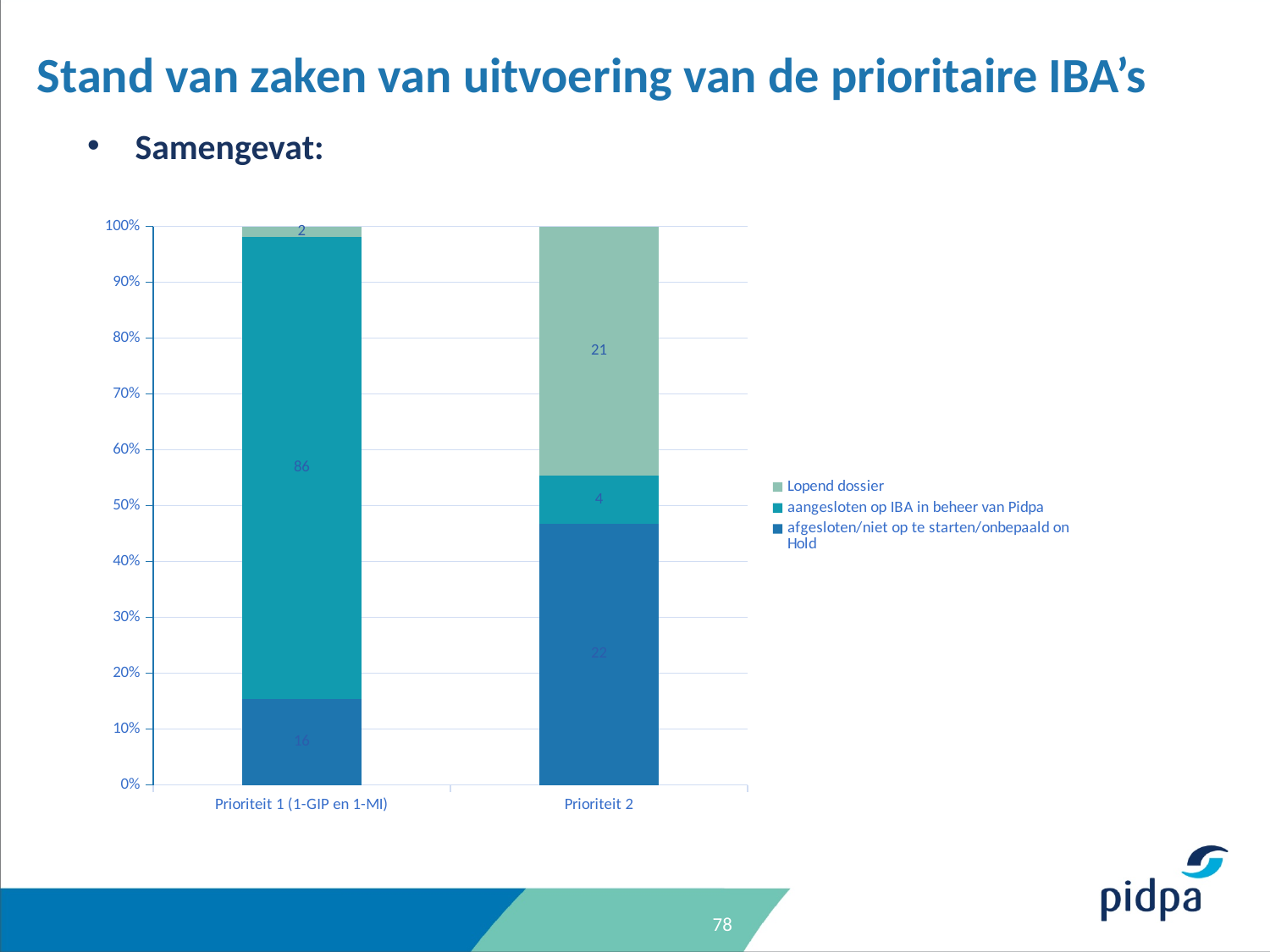
How many series does the legend list? 3 How many categories are shown on the x axis? 2 What is the difference between the 'afgesloten/niet op te starten/onbepaald on Hold' values for Prioriteit 2 and Prioriteit 1 (1-GIP en 1-MI)? 6 Which category has the larger 'aangesloten op IBA in beheer van Pidpa' value, Prioriteit 1 (1-GIP en 1-MI) or Prioriteit 2? Prioriteit 1 (1-GIP en 1-MI) What is the value of the 'Lopend dossier' segment for Prioriteit 1 (1-GIP en 1-MI)? 2 What is the value of the 'aangesloten op IBA in beheer van Pidpa' segment for Prioriteit 1 (1-GIP en 1-MI)? 86 What is the total of the data labels in the Prioriteit 1 (1-GIP en 1-MI) bar? 104 What kind of chart is shown on the slide? Stacked bar chart Is the share of 'Lopend dossier' in the Prioriteit 2 bar greater or less than 30%? greater What is the total of the data labels in the Prioriteit 2 bar? 47 What is the value of the 'Lopend dossier' segment for Prioriteit 2? 21 What is the value of the 'afgesloten/niet op te starten/onbepaald on Hold' segment for Prioriteit 2? 22